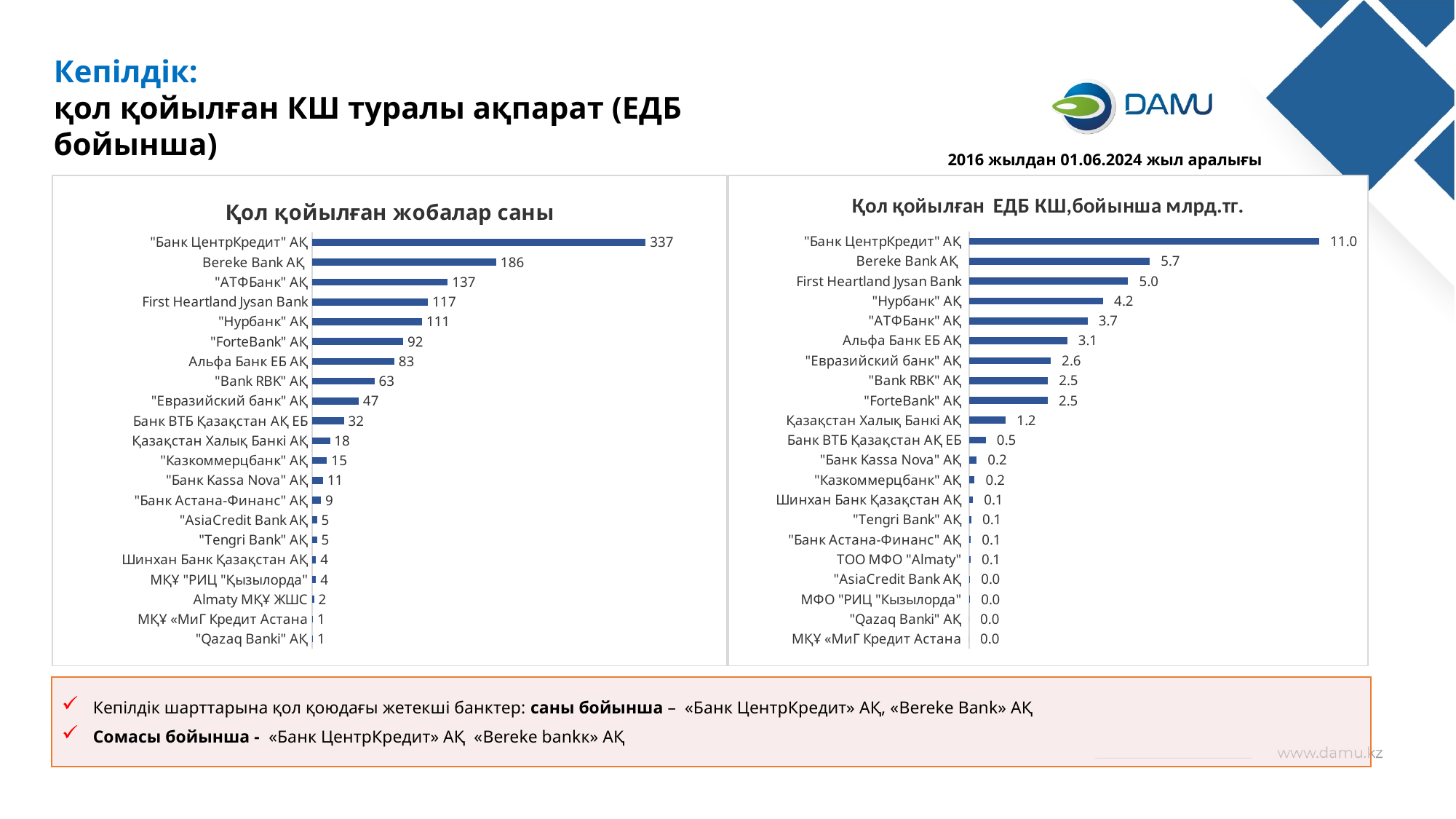
In the left chart "Қол қойылған жобалар саны", which is larger: "Нурбанк" АҚ or Альфа Банк ЕБ АҚ? "Нурбанк" АҚ In the right chart "Қол қойылған ЕДБ КШ,бойынша млрд.тг.", which is larger: First Heartland Jysan Bank or "АТФБанк" АҚ? First Heartland Jysan Bank In the left chart "Қол қойылған жобалар саны", what is the difference between Bereke Bank АҚ and "АТФБанк" АҚ? 49 What type of chart is the right chart "Қол қойылған ЕДБ КШ,бойынша млрд.тг."? Bar chart What is the title of the left chart? Қол қойылған жобалар саны In the right chart "Қол қойылған ЕДБ КШ,бойынша млрд.тг.", what is the difference between "Банк ЦентрКредит" АҚ and Bereke Bank АҚ? 5.3 In the right chart "Қол қойылған ЕДБ КШ,бойынша млрд.тг.", which bank has the highest value? "Банк ЦентрКредит" АҚ In the right chart "Қол қойылған ЕДБ КШ,бойынша млрд.тг.", what is the value for "Нурбанк" АҚ? 4.2 How many banks are listed in the left chart "Қол қойылған жобалар саны"? 21 In the left chart "Қол қойылған жобалар саны", what is the value for "ForteBank" АҚ? 92 In the right chart "Қол қойылған ЕДБ КШ,бойынша млрд.тг.", what is the value for Қазақстан Халық Банкі АҚ? 1.2 In the left chart "Қол қойылған жобалар саны", what is the value for "Банк ЦентрКредит" АҚ? 337